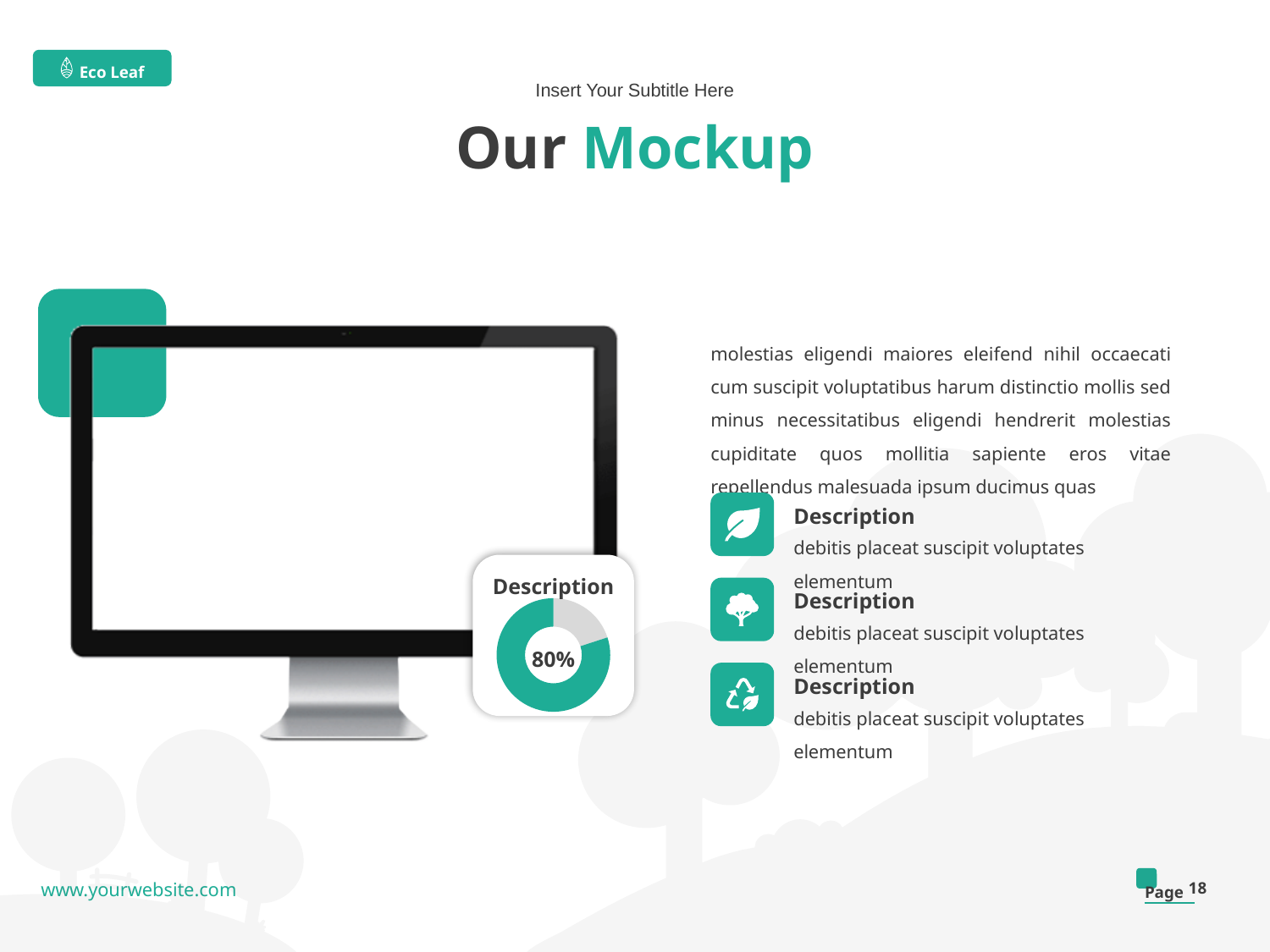
How many slices does the doughnut chart have? 2 What colour is the slice that represents 80% in the doughnut chart? green What is the title of the doughnut chart? Description What percentage is shown in the centre of the doughnut chart? 80% Which slice of the doughnut chart is larger, the green one or the grey one? the green one What kind of chart is shown on the slide? doughnut chart